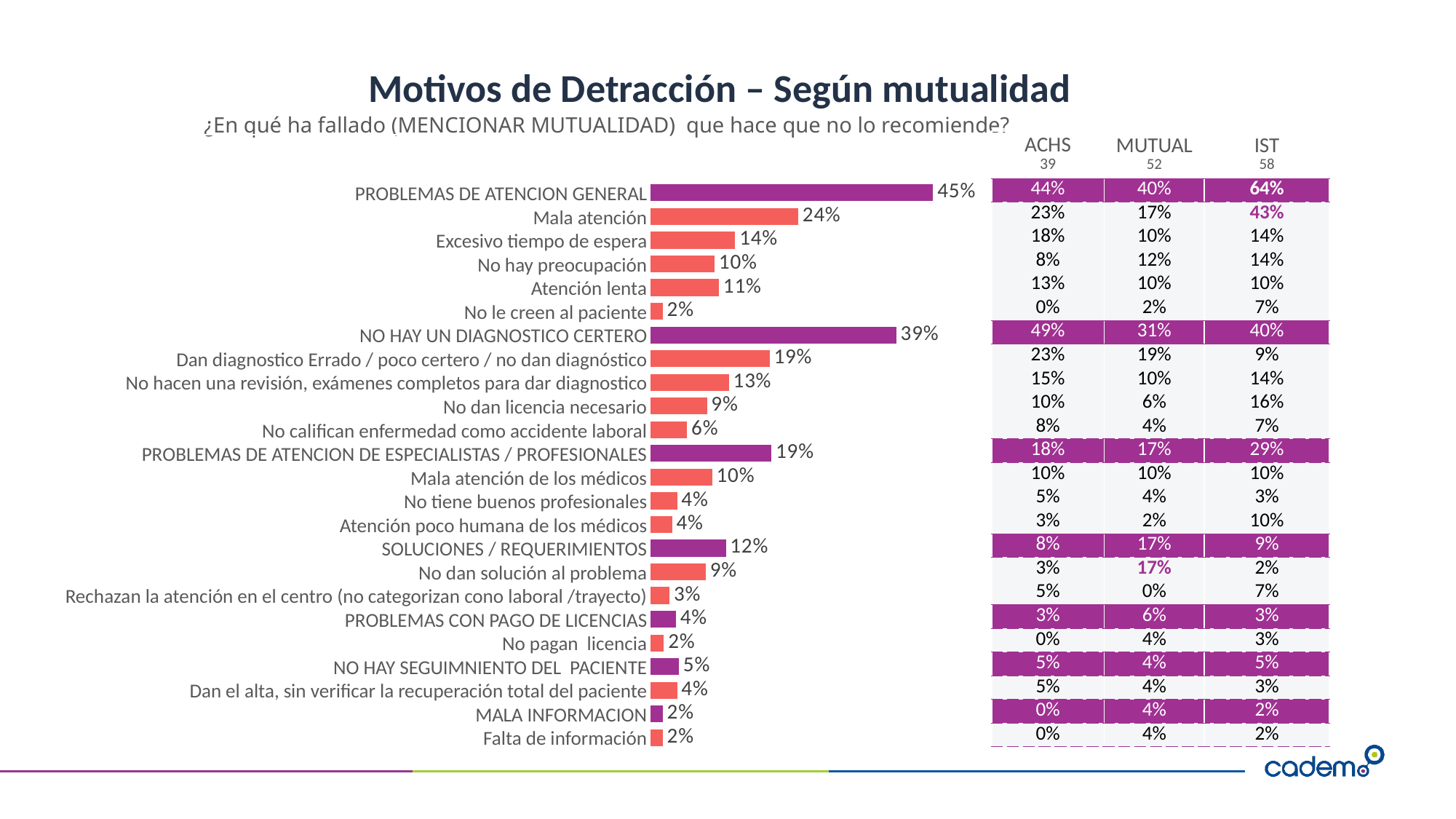
What is the value shown for SOLUCIONES / REQUERIMIENTOS in the bar chart? 12% What is the value shown for Mala atención in the bar chart? 24% What type of chart is shown on the slide? Bar chart Which has a larger value in the bar chart: Atención lenta or No hay preocupación? Atención lenta What is the value shown for Excesivo tiempo de espera in the bar chart? 14% Which category has the highest value in the bar chart? PROBLEMAS DE ATENCION GENERAL What is the value shown for NO HAY UN DIAGNOSTICO CERTERO in the bar chart? 39% How many bars are plotted in the bar chart? 24 What is the title of the slide's chart? Motivos de Detracción – Según mutualidad Which has a larger value in the bar chart: Mala atención or Dan diagnostico Errado / poco certero / no dan diagnóstico? Mala atención What is the difference between the values for PROBLEMAS DE ATENCION GENERAL and NO HAY UN DIAGNOSTICO CERTERO in the bar chart? 6 percentage points What is the value shown for PROBLEMAS DE ATENCION GENERAL in the bar chart? 45%